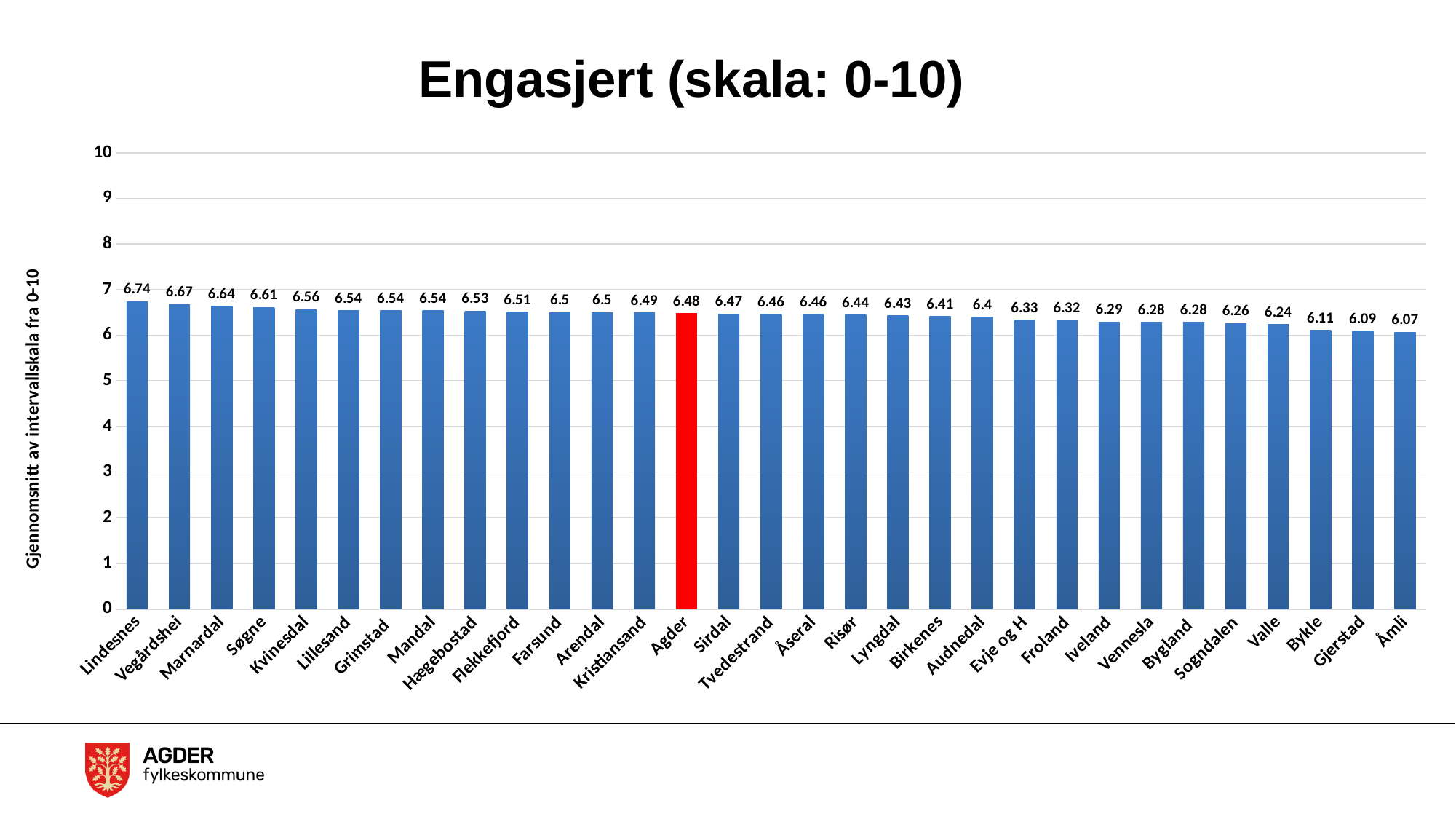
How many categories are shown on the x axis? 31 Which category has the highest value? Lindesnes What is the value for Kristiansand? 6.49 What is the value for Bykle? 6.11 Which has a larger value, Vegårdshei or Gjerstad? Vegårdshei What is the difference between the values for Lindesnes and Åmli? 0.67 Is the value for Arendal greater or less than 7? less Do the values rise or fall from left to right along the x axis? fall Which category has the lowest value? Åmli Which bar is coloured red instead of blue? Agder What kind of chart is this? bar chart What is the value for Agder? 6.48